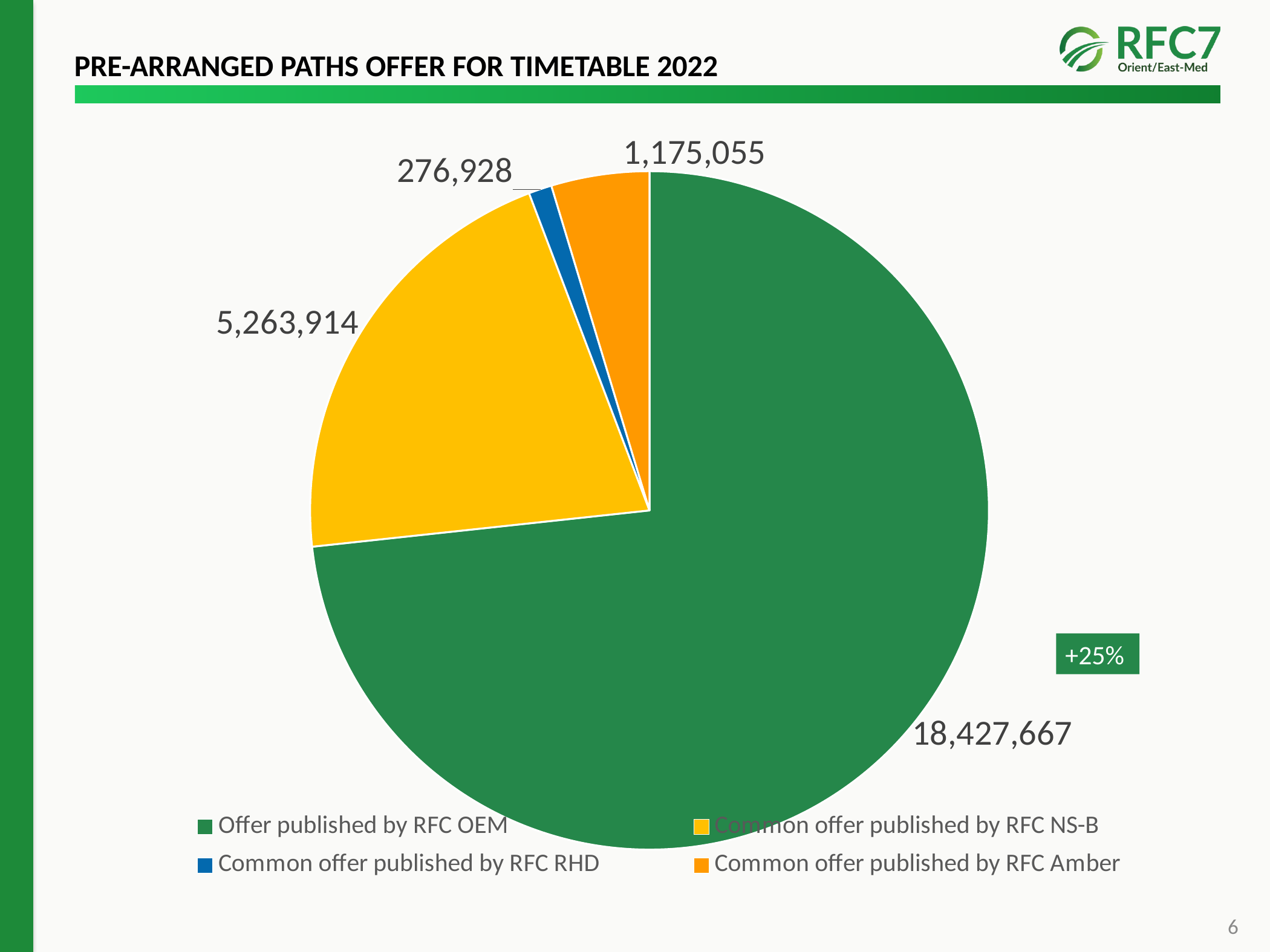
What is the difference between the value for Common offer published by RFC Amber and the value for Common offer published by RFC RHD? 898,127 What is the difference between the value for Offer published by RFC OEM and the value for Common offer published by RFC NS-B? 13,163,753 Which is larger, the value for Common offer published by RFC Amber or the value for Common offer published by RFC RHD? Common offer published by RFC Amber What is the title of the slide containing the pie chart? PRE-ARRANGED PATHS OFFER FOR TIMETABLE 2022 Which category has the largest slice of the pie? Offer published by RFC OEM What kind of chart is shown on the slide? Pie chart What is the value for Offer published by RFC OEM? 18,427,667 How many categories does the pie chart show? 4 What is the value for Common offer published by RFC Amber? 1,175,055 What is the value for Common offer published by RFC RHD? 276,928 What is the value for Common offer published by RFC NS-B? 5,263,914 Which category has the smallest slice of the pie? Common offer published by RFC RHD